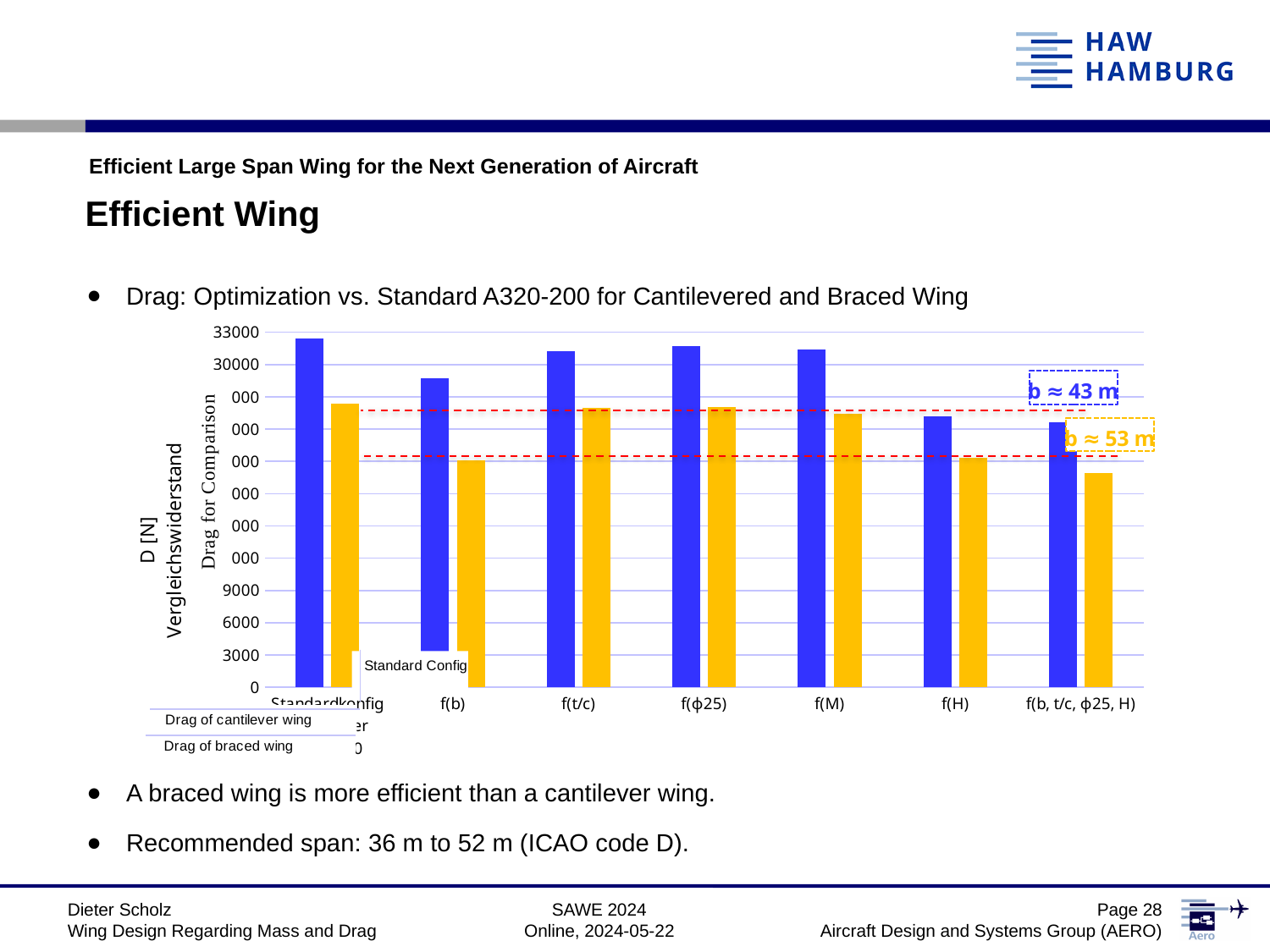
Which category has the highest drag of cantilever wing? Standardkonfig Is the drag of cantilever wing for Standardkonfig greater or less than 30000? greater What colour are the bars for the drag of cantilever wing? blue Is the drag of cantilever wing for f(b) greater or less than 30000? less What span value is given in the blue annotation box on the chart? b ≈ 43 m How many categories are shown along the x axis of the chart? 7 Is the drag of braced wing for f(t/c) greater or less than 30000? less How many series does the chart's legend list? 2 What kind of chart is shown on the slide? bar chart Which category has the lowest drag of braced wing? f(b, t/c, ϕ25, H) Which is larger, the drag of braced wing for f(b) or for f(t/c)? f(t/c) Which is larger, the drag of cantilever wing for f(t/c) or for f(b)? f(t/c)